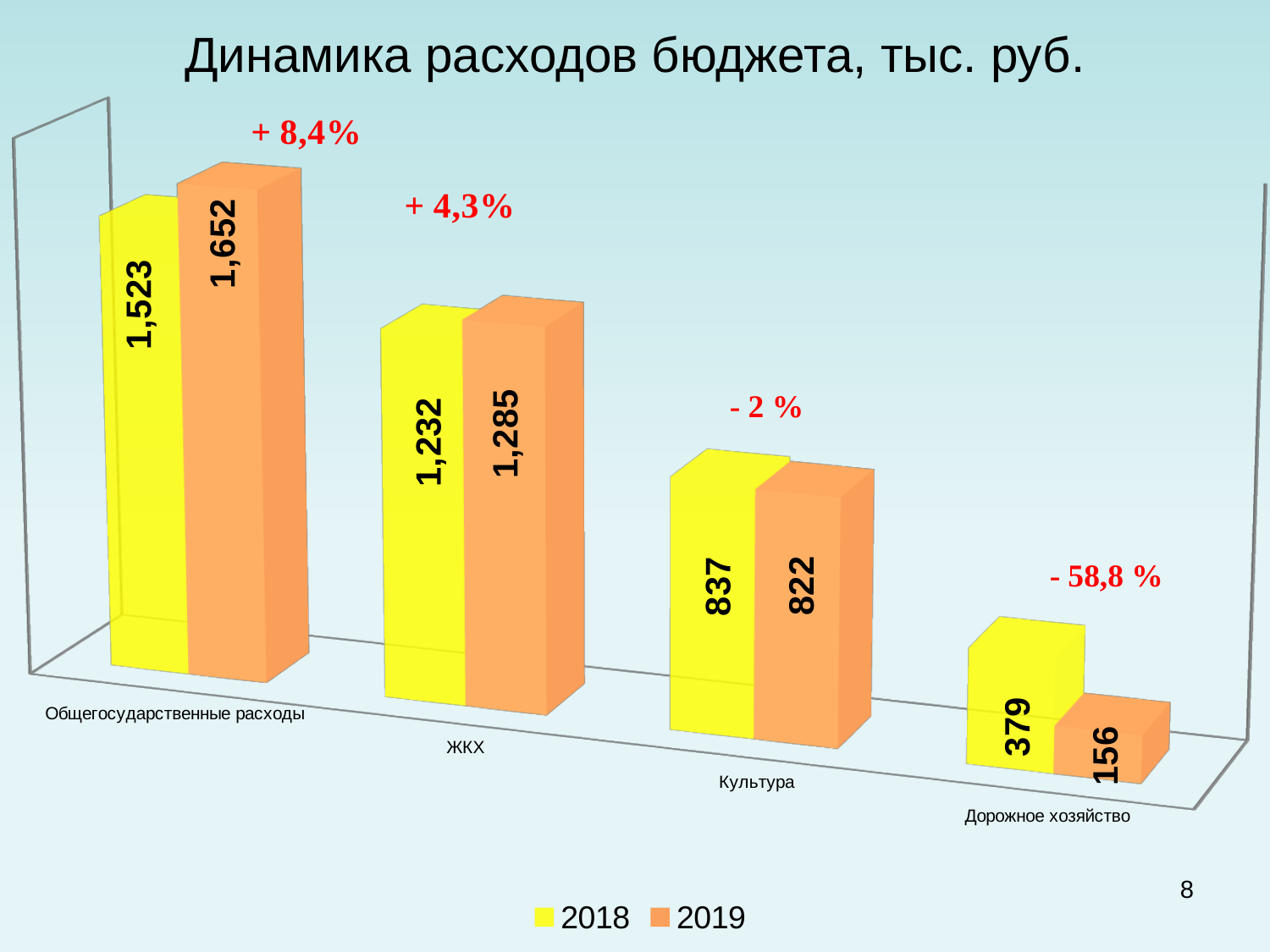
What is the difference between the 2018 and 2019 values for Дорожное хозяйство? 223 Which category has the lowest 2018 value? Дорожное хозяйство What is the 2018 value for Общегосударственные расходы? 1,523 What is the 2018 value for Культура? 837 What kind of chart is shown on the slide? Bar chart How many series does the legend list? 2 Which is larger for Культура, the 2018 value or the 2019 value? 2018 Which category has the highest 2019 value? Общегосударственные расходы What is the difference between the 2019 and 2018 values for Общегосударственные расходы? 129 What is the 2019 value for Дорожное хозяйство? 156 What is the 2019 value for ЖКХ? 1,285 How many categories are shown on the x axis? 4